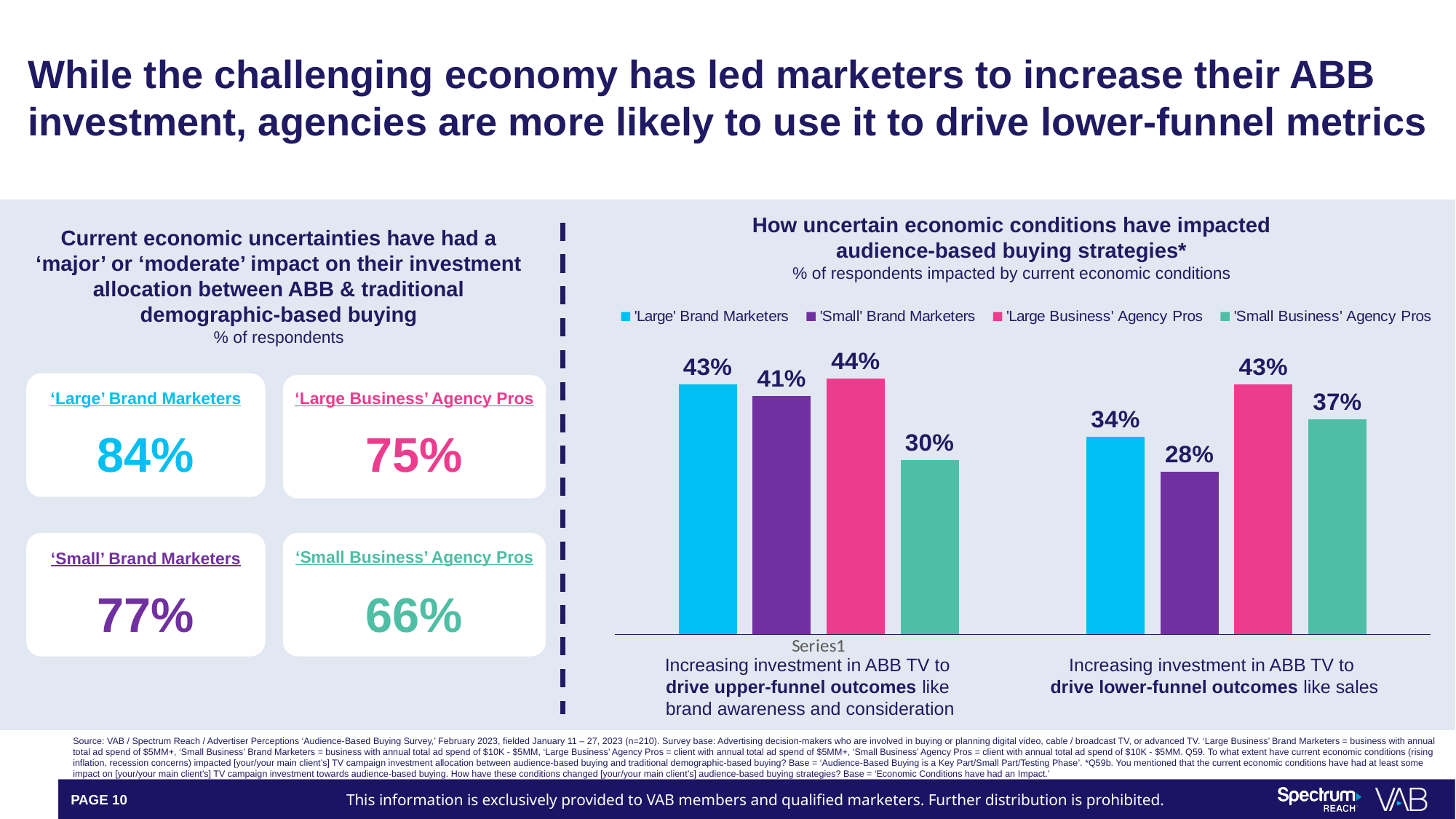
In the bar chart, what is the value for 'Small Business' Agency Pros for increasing investment in ABB TV to drive upper-funnel outcomes? 30% In the bar chart, what is the value for 'Small' Brand Marketers for increasing investment in ABB TV to drive lower-funnel outcomes like sales? 28% In the bar chart, how many category groups are plotted along the x axis? 2 In the bar chart, which series has the lowest value for increasing investment in ABB TV to drive upper-funnel outcomes? 'Small Business' Agency Pros In the bar chart, which series has the highest value for increasing investment in ABB TV to drive lower-funnel outcomes like sales? 'Large Business' Agency Pros In the bar chart, how many series does the legend list? 4 In the bar chart, what colour represents 'Small' Brand Marketers in the legend? purple In the bar chart, which is larger for 'Small Business' Agency Pros: the upper-funnel outcomes value or the lower-funnel outcomes value? lower-funnel outcomes In the bar chart, what is the difference between 'Large' Brand Marketers and 'Small' Brand Marketers for increasing investment in ABB TV to drive lower-funnel outcomes like sales? 6% In the bar chart, what is the value for 'Large Business' Agency Pros for increasing investment in ABB TV to drive upper-funnel outcomes? 44% What kind of chart is shown on the right side of the slide? bar chart In the bar chart, does the value for 'Large' Brand Marketers rise or fall from the upper-funnel outcomes group to the lower-funnel outcomes group? fall